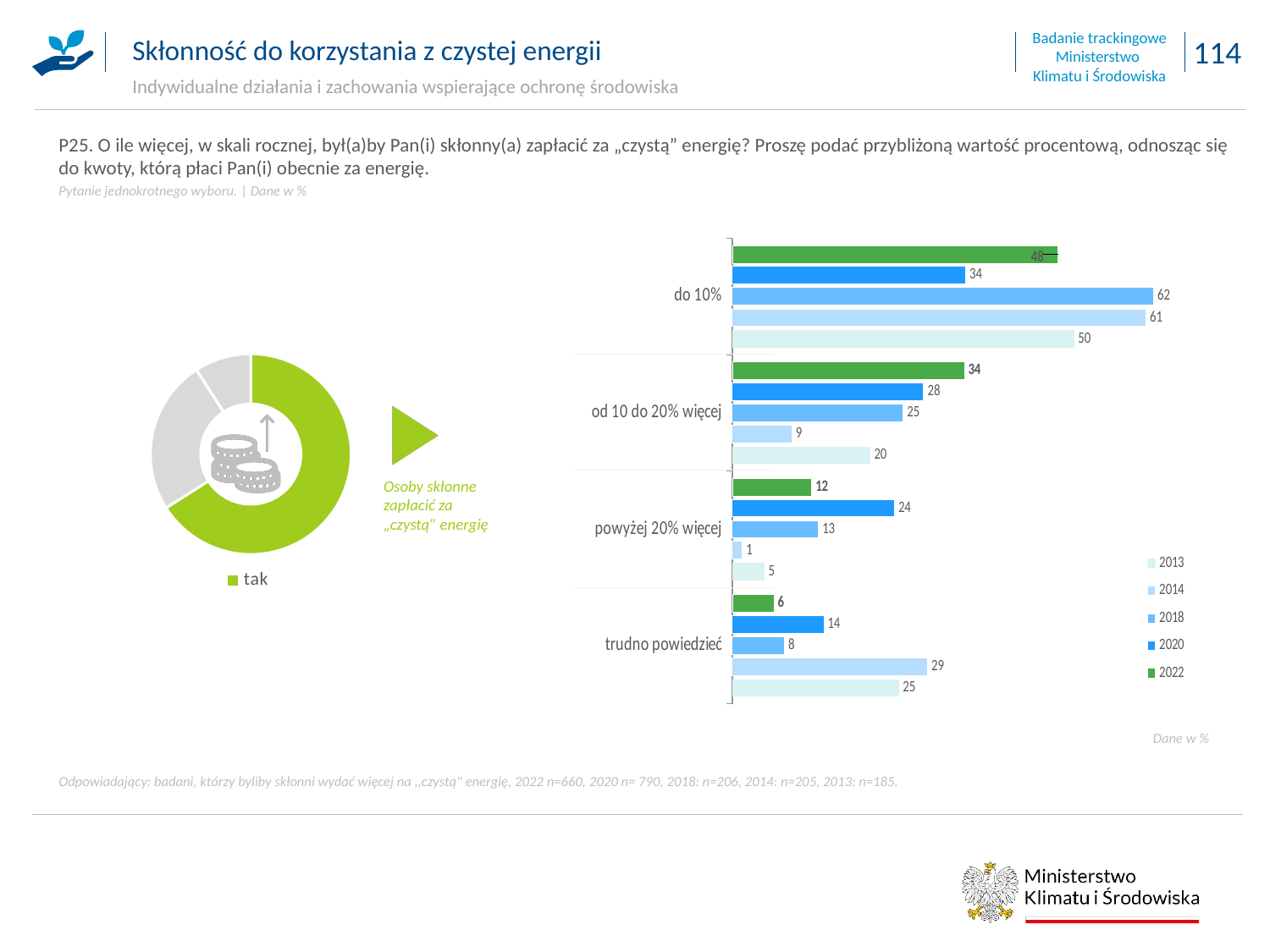
In the bar chart on the right, which year has the highest value in the 'do 10%' category? 2018 In the bar chart on the right, which year has the lowest value in the 'od 10 do 20% więcej' category? 2014 In the bar chart on the right, what is the value for 2014 in the 'powyżej 20% więcej' category? 1 In the bar chart on the right, which colour represents the 2022 series? Green In the bar chart on the right, what is the value for 2022 in the 'do 10%' category? 48 In the bar chart on the right, what is the value for 2018 in the 'do 10%' category? 62 In the bar chart on the right, what is the difference between the 2020 and 2022 values in the 'powyżej 20% więcej' category? 12 How many series does the legend of the bar chart on the right list? 5 How many categories are shown on the bar chart on the right? 4 What kind of chart is the chart on the left of the slide? Donut chart In the bar chart on the right, which is larger in the 'trudno powiedzieć' category: the value for 2014 or the value for 2020? 2014 In the bar chart on the right, what is the value for 2013 in the 'trudno powiedzieć' category? 25